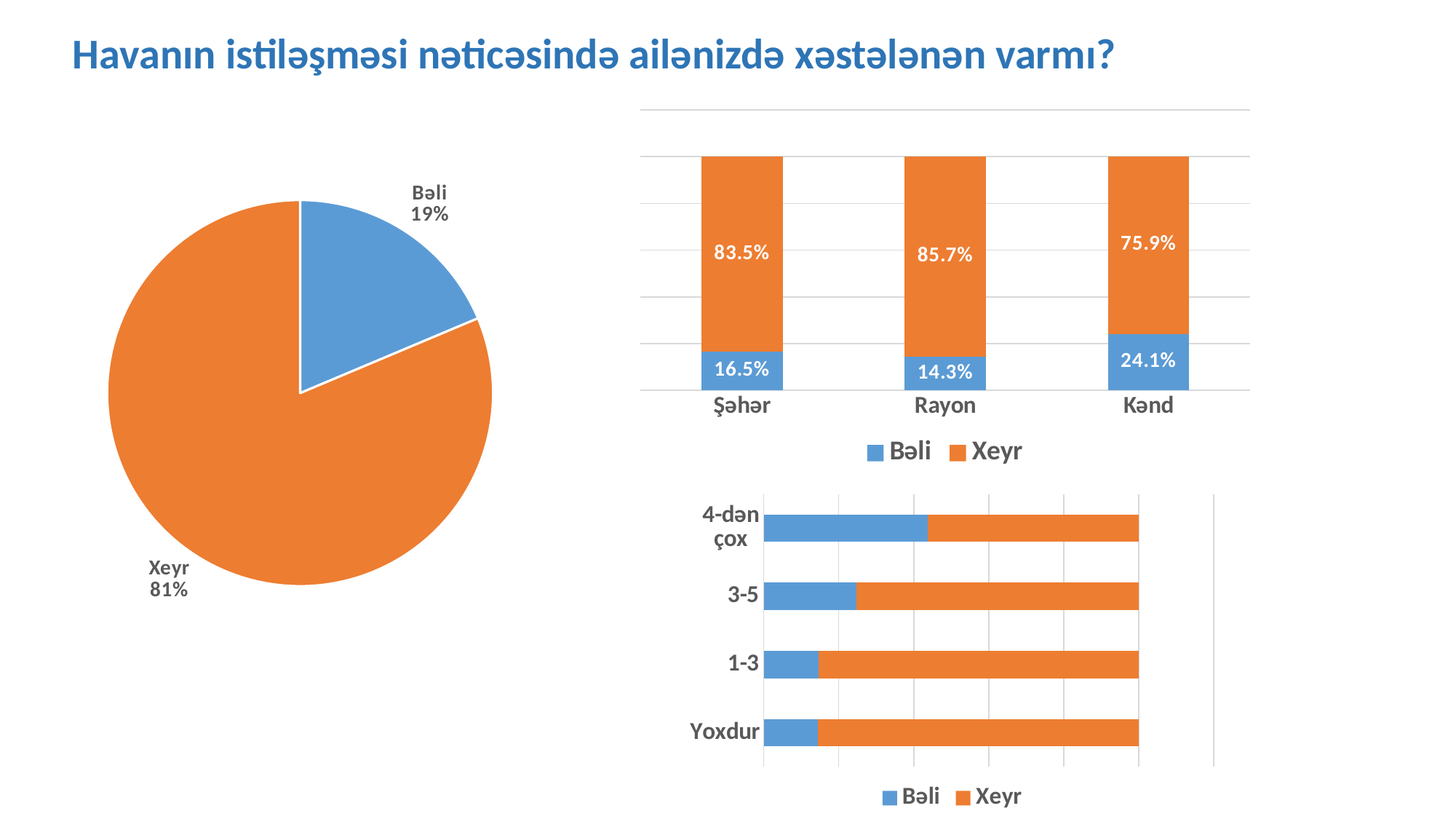
In the pie chart on the left, which slice is larger, Bəli or Xeyr? Xeyr In the stacked bar chart at the top right, which category has the highest Bəli value? Kənd In the pie chart on the left, what share of the pie is labelled Bəli? 19% In the horizontal bar chart at the bottom right, how many categories are shown? 4 In the horizontal bar chart at the bottom right, how many series does the legend list? 2 In the stacked bar chart at the top right, how many categories are shown on the x axis? 3 In the pie chart on the left, what share of the pie is labelled Xeyr? 81% In the stacked bar chart at the top right, what is the Xeyr value for Rayon? 85.7% In the stacked bar chart at the top right, which category has the lowest Xeyr value? Kənd In the stacked bar chart at the top right, what is the difference between the Bəli values for Kənd and Rayon? 9.8% In the stacked bar chart at the top right, what is the Bəli value for Kənd? 24.1% In the stacked bar chart at the top right, what is the Bəli value for Şəhər? 16.5%